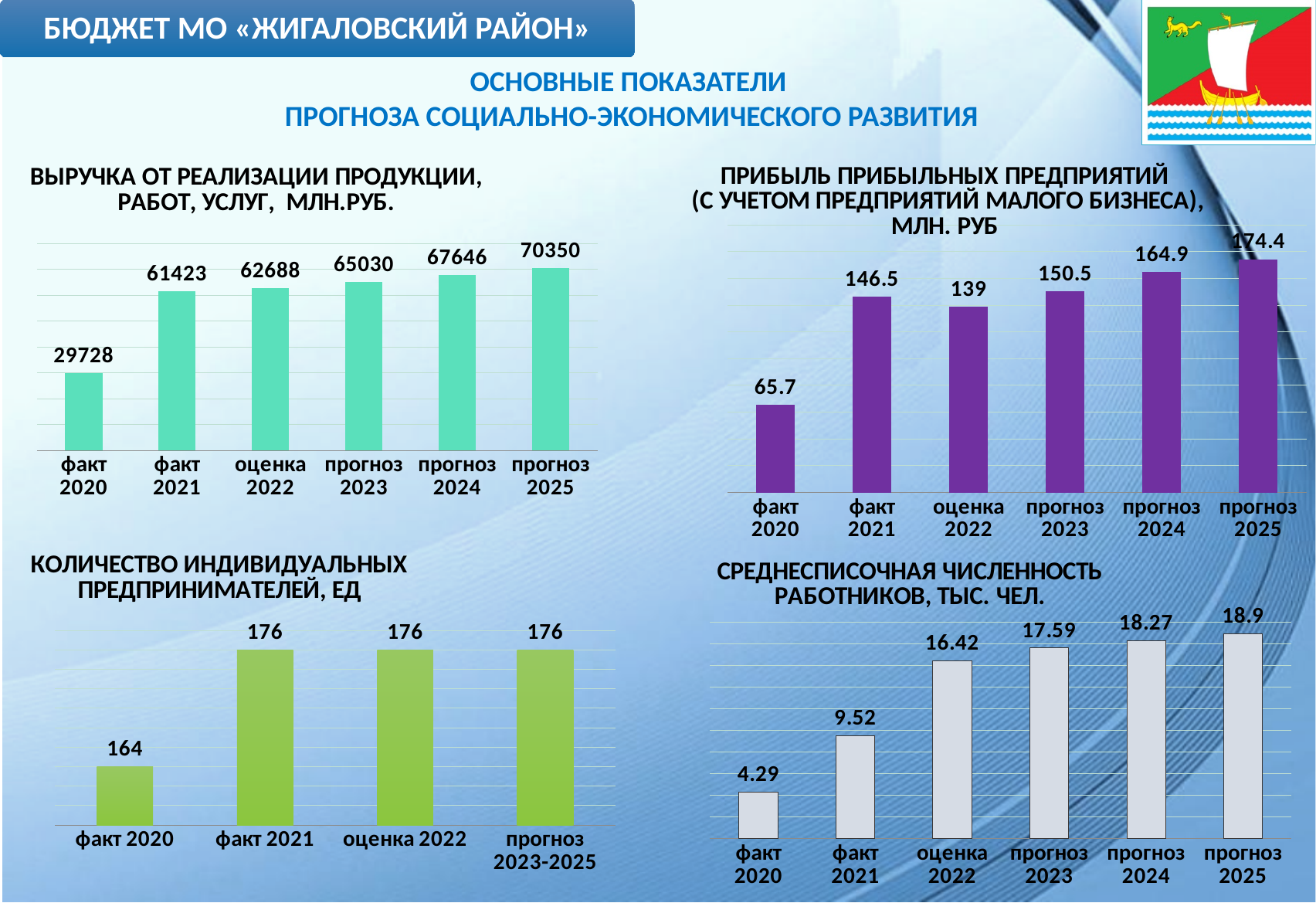
In the top-right chart (ПРИБЫЛЬ ПРИБЫЛЬНЫХ ПРЕДПРИЯТИЙ), which category has the lowest value? факт 2020 In the bottom-left chart (КОЛИЧЕСТВО ИНДИВИДУАЛЬНЫХ ПРЕДПРИНИМАТЕЛЕЙ), how many categories are shown? 4 What type of chart is the top-right chart (ПРИБЫЛЬ ПРИБЫЛЬНЫХ ПРЕДПРИЯТИЙ)? bar chart In the top-left chart (ВЫРУЧКА ОТ РЕАЛИЗАЦИИ ПРОДУКЦИИ, РАБОТ, УСЛУГ), which category has the highest value? прогноз 2025 In the top-left chart (ВЫРУЧКА ОТ РЕАЛИЗАЦИИ ПРОДУКЦИИ, РАБОТ, УСЛУГ), what is the difference between прогноз 2025 and прогноз 2024? 2704 In the top-right chart (ПРИБЫЛЬ ПРИБЫЛЬНЫХ ПРЕДПРИЯТИЙ), which is larger: факт 2021 or оценка 2022? факт 2021 In the bottom-left chart (КОЛИЧЕСТВО ИНДИВИДУАЛЬНЫХ ПРЕДПРИНИМАТЕЛЕЙ), what is the value for факт 2020? 164 In the top-right chart (ПРИБЫЛЬ ПРИБЫЛЬНЫХ ПРЕДПРИЯТИЙ), what is the value for оценка 2022? 139 In the top-left chart (ВЫРУЧКА ОТ РЕАЛИЗАЦИИ ПРОДУКЦИИ, РАБОТ, УСЛУГ), what is the value for факт 2020? 29728 In the bottom-right chart (СРЕДНЕСПИСОЧНАЯ ЧИСЛЕННОСТЬ РАБОТНИКОВ), what is the value for прогноз 2024? 18.27 In the bottom-right chart (СРЕДНЕСПИСОЧНАЯ ЧИСЛЕННОСТЬ РАБОТНИКОВ), what is the difference between факт 2021 and факт 2020? 5.23 In the bottom-right chart (СРЕДНЕСПИСОЧНАЯ ЧИСЛЕННОСТЬ РАБОТНИКОВ), do the values rise or fall from факт 2020 to прогноз 2025? rise